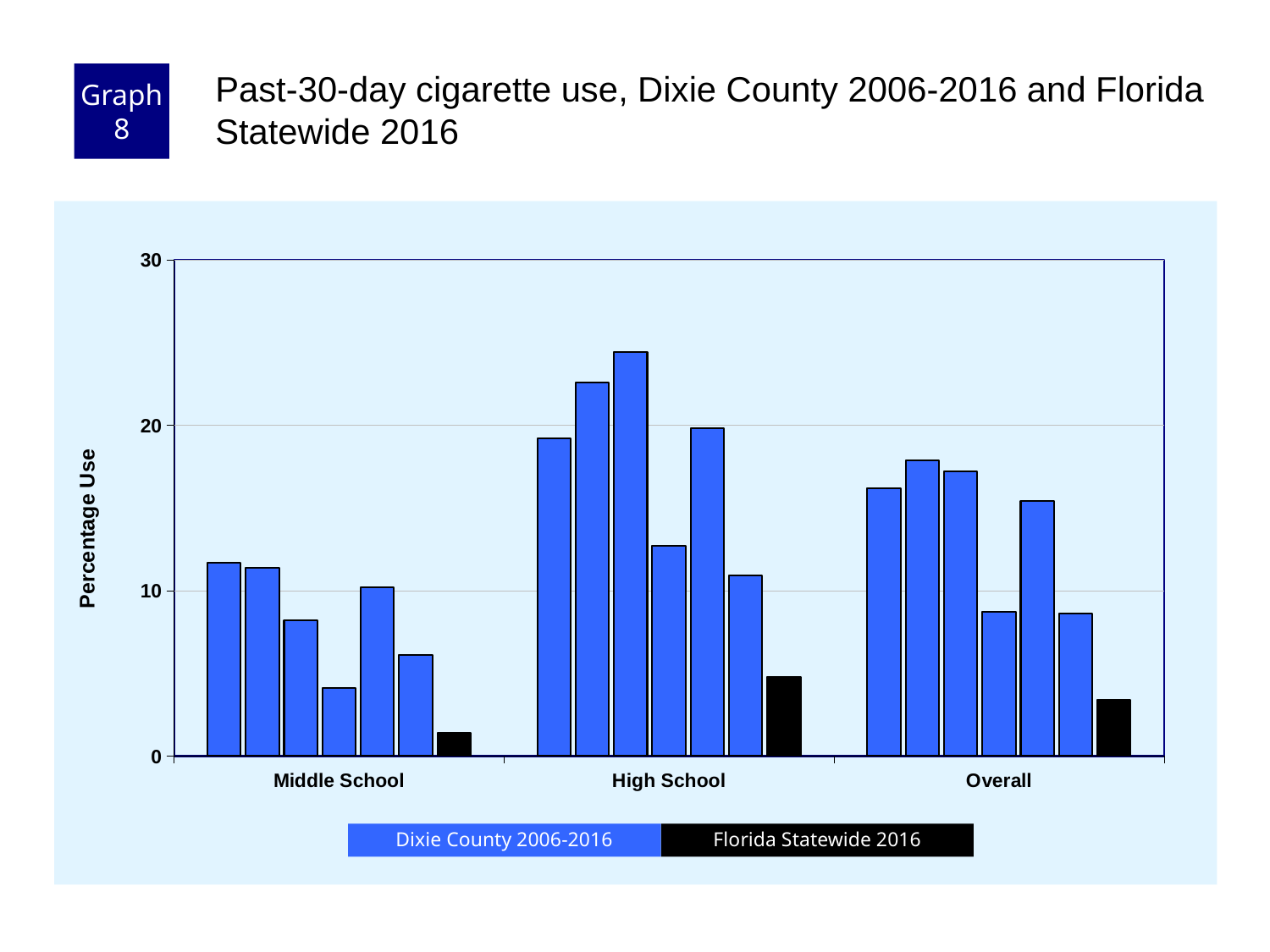
Is the Florida Statewide 2016 value for Middle School greater or less than 10? less Which series is drawn in black? Florida Statewide 2016 Is the Florida Statewide 2016 value for High School greater or less than 10? less Which category contains the tallest bar in the chart? High School Is the tallest Dixie County 2006-2016 bar in the Overall group greater or less than 20? less Which is larger, the Florida Statewide 2016 value for High School or for Middle School? High School What is the label of the y axis? Percentage Use What kind of chart is shown on the slide? bar chart Which category has the lowest Florida Statewide 2016 value? Middle School How many categories are shown along the x axis? 3 How many series does the legend list? 2